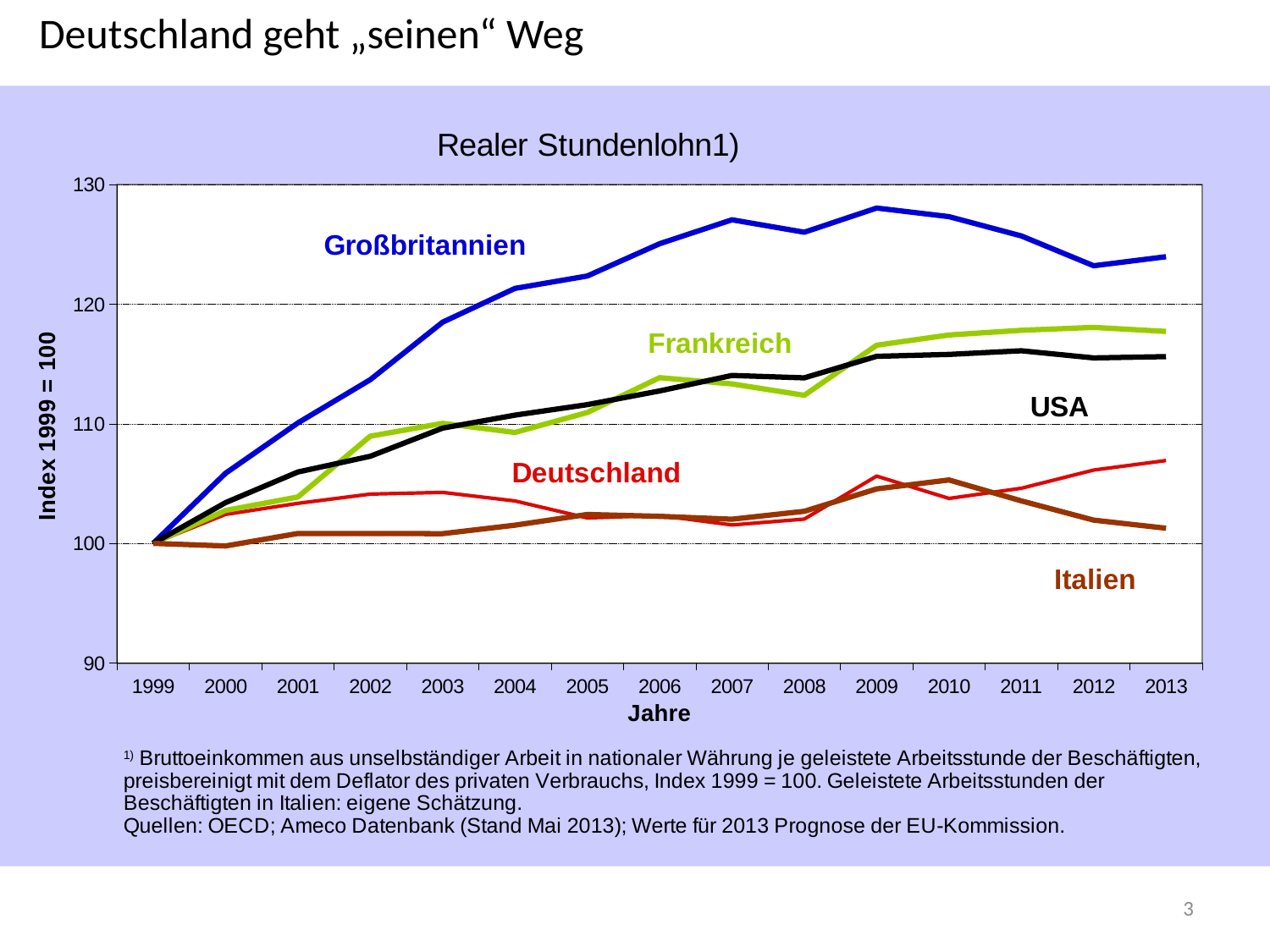
What is the title of the chart? Realer Stundenlohn1) How many countries are plotted as lines in the chart? 5 Which country has the lowest index value in 2013? Italien Which is larger in 2007, the value for Großbritannien or the value for Italien? Großbritannien Which country has the highest index value in 2013? Großbritannien Does the line for Großbritannien rise or fall between 1999 and 2009? rise Is the value for Frankreich in 2013 greater or less than 110? greater Is the value for Großbritannien in 2009 greater or less than 120? greater Is the value for Italien in 2013 greater or less than 110? less How many years are shown on the x axis of the chart? 15 What is the index value for all countries in 1999? 100 What kind of chart is shown on the slide? line chart